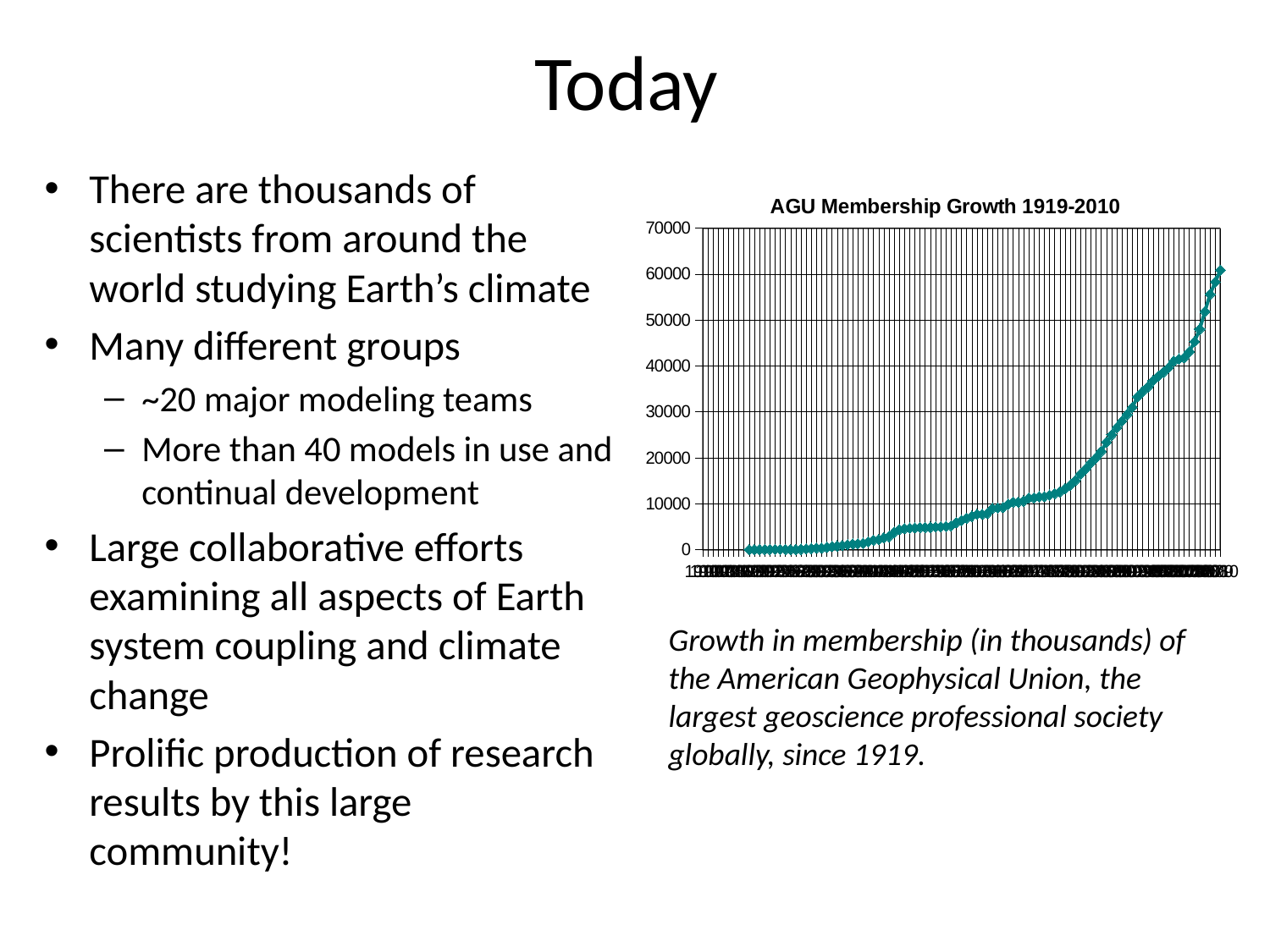
What is the title of the chart on the slide? AGU Membership Growth 1919-2010 Is the membership value at the right end of the chart (2010) greater or less than 50000? greater Is the membership value at the right end of the chart (2010) greater or less than 70000? less Do the membership values in the chart generally rise or fall from left to right along the x axis? rise What kind of chart is shown on the slide? line chart Is the membership value at the left end of the chart (1919) greater or less than 10000? less How many data series (lines) are plotted in the chart? 1 What is the highest value shown on the y axis of the chart? 70000 Is the lowest membership value in the chart at the beginning or the end of the period? beginning Is the highest membership value in the chart at the beginning or the end of the period? end